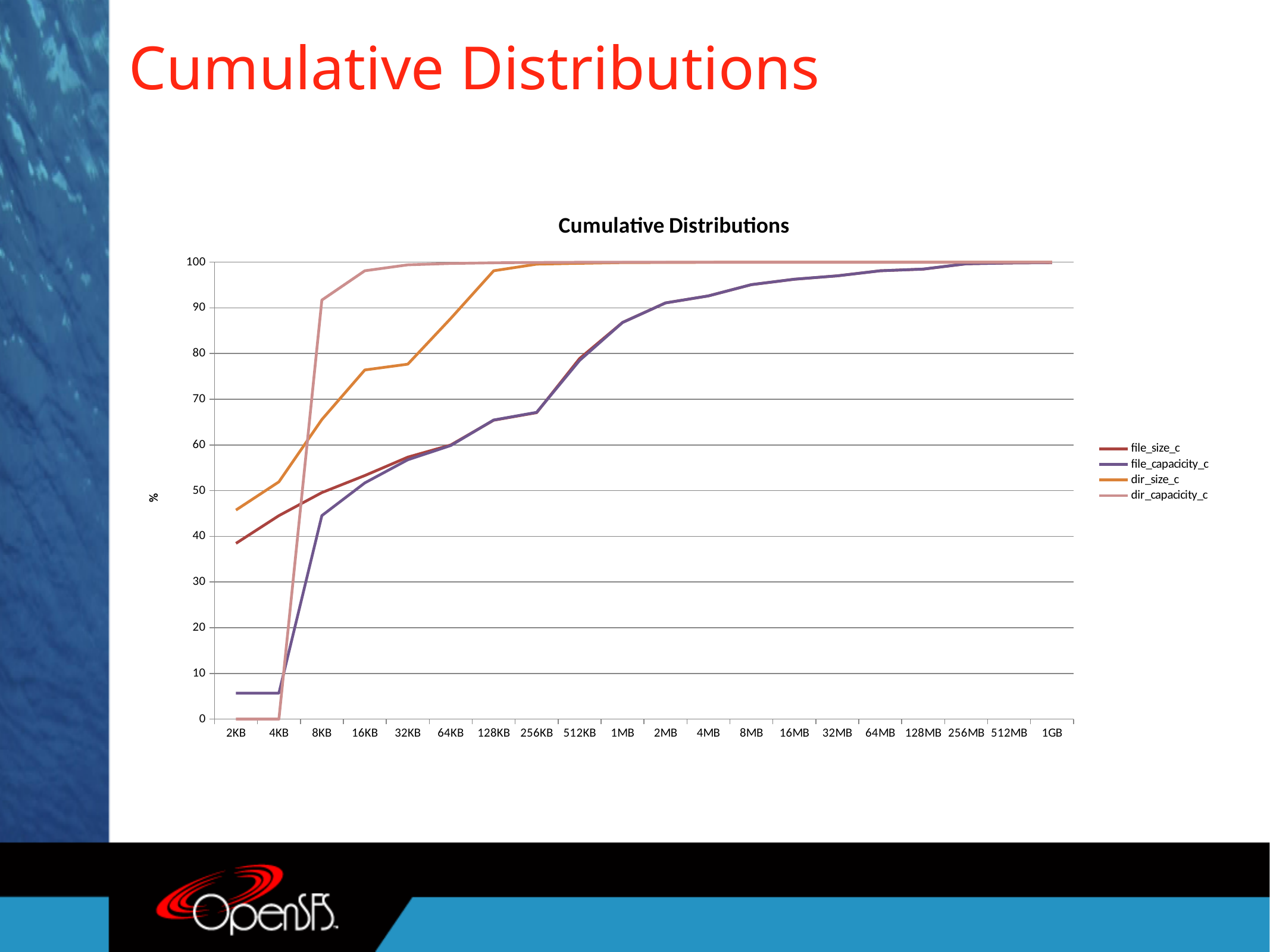
Is the value for dir_capacity_c at 8KB greater or less than 90? greater What is the label on the y axis? % Is the value for dir_size_c at 128KB greater or less than 90? greater What kind of chart is shown on the slide? line chart How many categories are on the x axis? 20 Is the value for file_size_c at 2KB greater or less than 40? less How many series does the legend list? 4 Do the values of the file_capacity_c series rise or fall along the x axis? rise At 8KB, which series has the larger value, dir_capacity_c or file_capacity_c? dir_capacity_c At 2KB, which series has the larger value, dir_size_c or file_size_c? dir_size_c